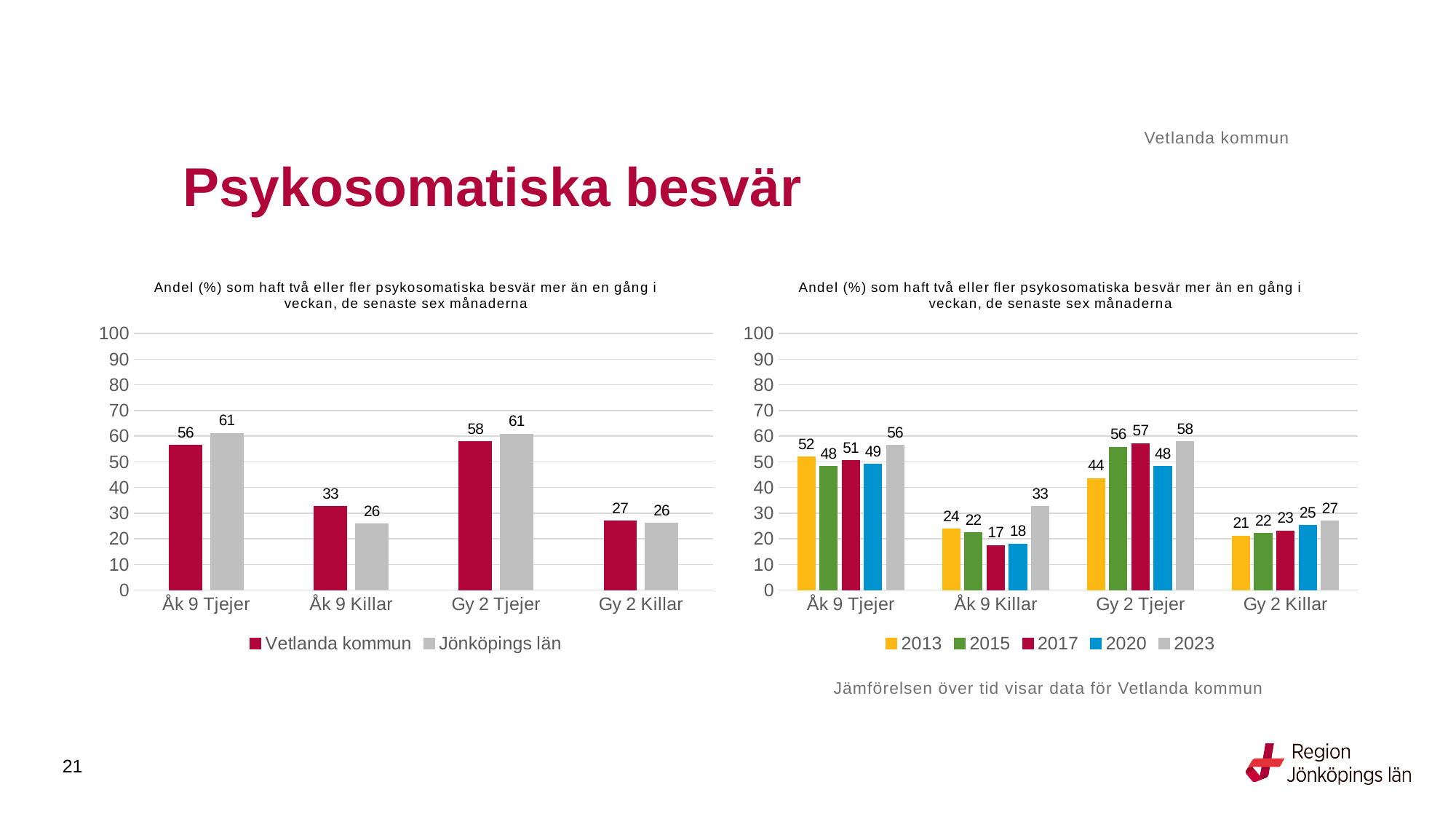
In the right chart, do the values for Gy 2 Killar rise or fall from 2013 to 2023? rise In the right chart, is the value for 2013 for Gy 2 Tjejer larger or smaller than the value for 2015 for Gy 2 Tjejer? smaller In the left chart, what is the difference between Vetlanda kommun and Jönköpings län for Åk 9 Killar? 7 In the right chart, which year has the highest value for Åk 9 Killar? 2023 In the left chart, which category has the lowest value for Jönköpings län? Gy 2 Killar In the right chart, what is the value for 2017 for Åk 9 Killar? 17 In the left chart, what is the value for Vetlanda kommun for Åk 9 Tjejer? 56 In the right chart, what is the value for 2023 for Gy 2 Tjejer? 58 What kind of chart is the left chart? bar chart In the left chart, how many series does the legend list? 2 In the right chart, how many series does the legend list? 5 In the left chart, what is the value for Jönköpings län for Åk 9 Killar? 26